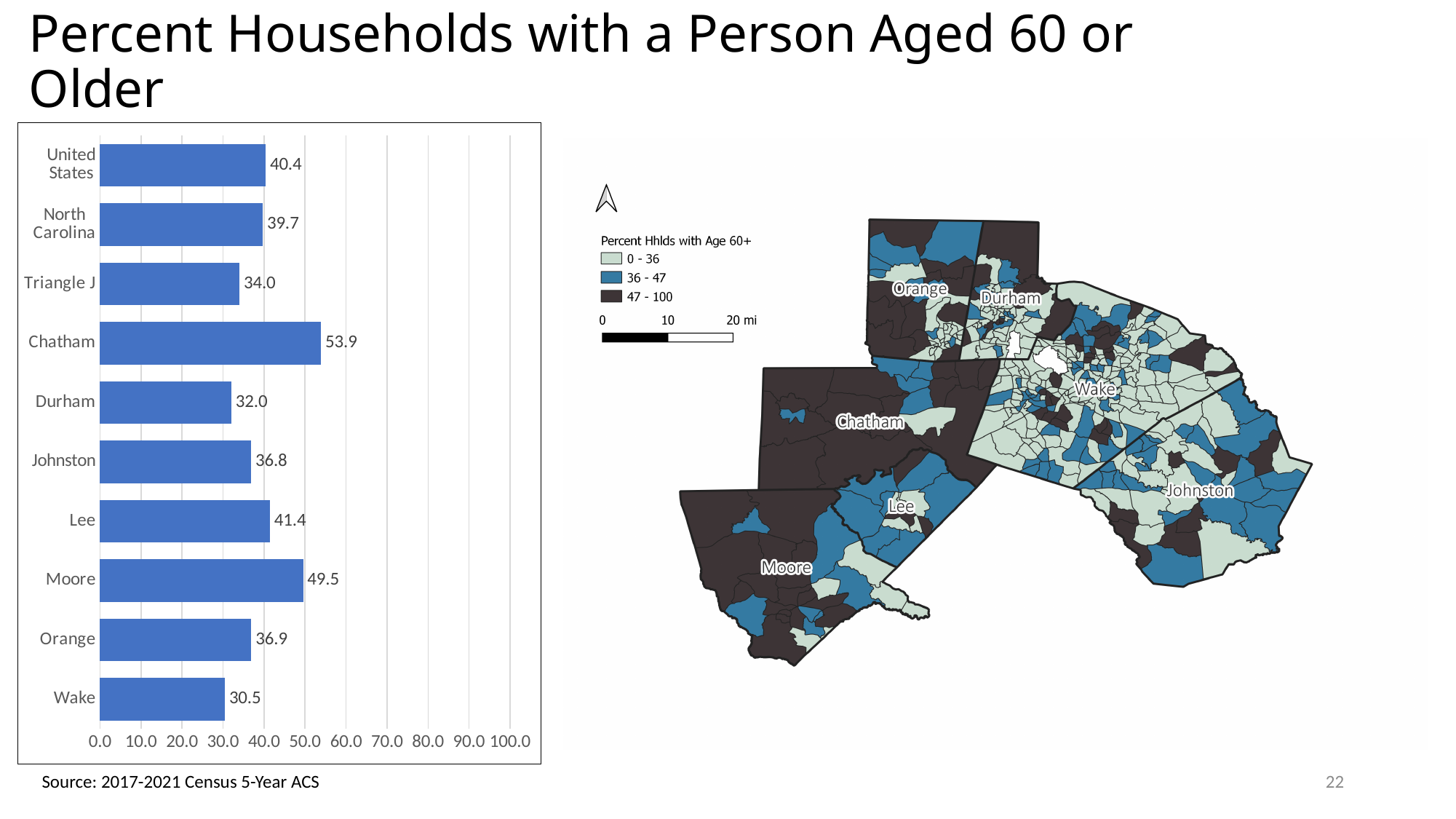
What is the difference between the values for the United States and Wake in the bar chart? 9.9 What is the difference between the values for Moore and Durham in the bar chart? 17.5 How many categories are shown in the bar chart? 10 Which is larger in the bar chart, the value for Lee or the value for Johnston? Lee What kind of chart is shown on the left of the slide? bar chart Is the value for Triangle J in the bar chart greater or less than 40.0? less How many classes does the map legend list for Percent Hhlds with Age 60+? 3 Which category has the lowest value in the bar chart? Wake What is the value for Chatham in the bar chart? 53.9 What is the value for Wake in the bar chart? 30.5 Which category has the highest value in the bar chart? Chatham What is the value for North Carolina in the bar chart? 39.7